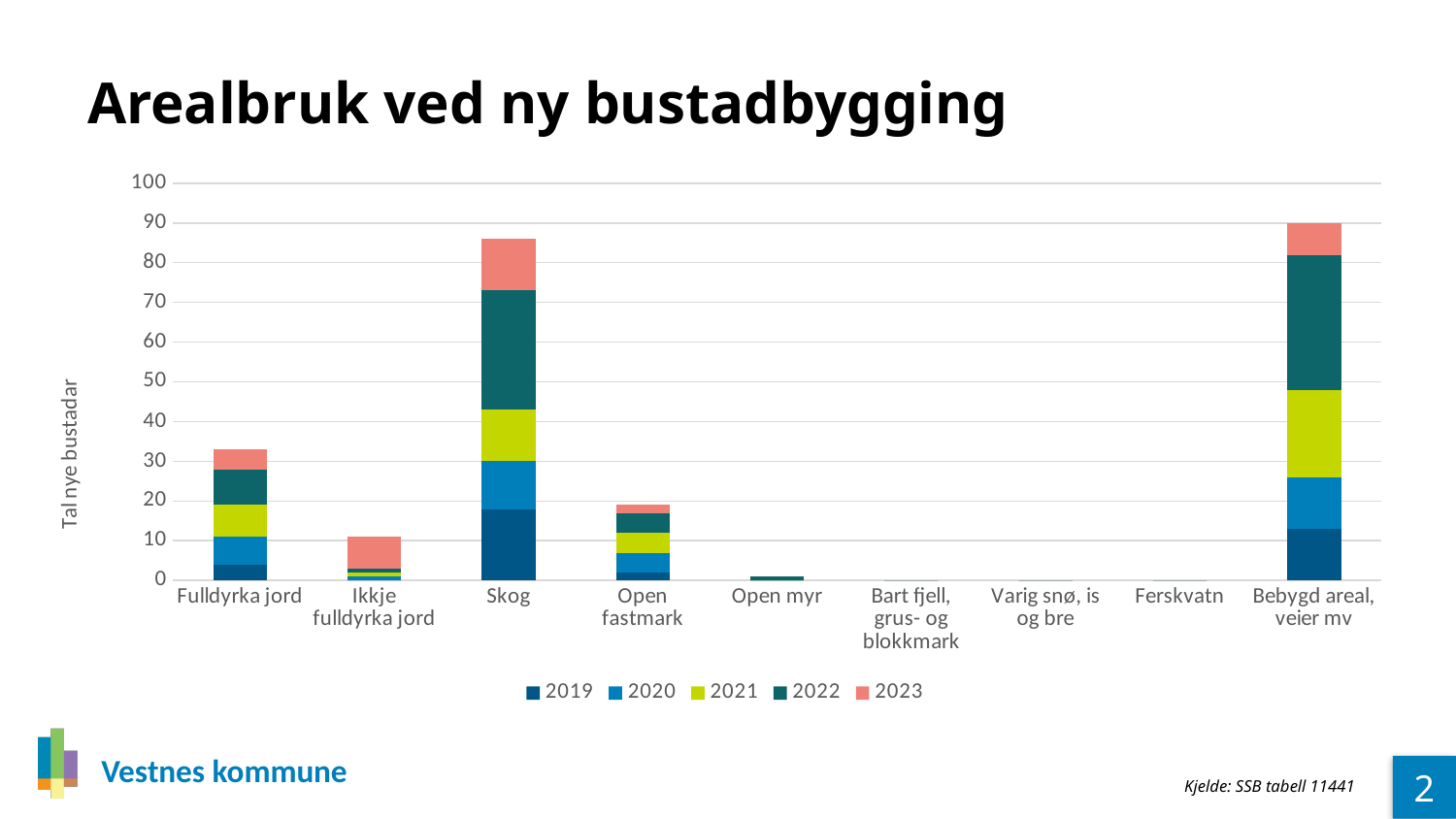
Which has the larger total stacked value, Skog or Fulldyrka jord? Skog Which has the larger total stacked value, Open fastmark or Ikkje fulldyrka jord? Open fastmark How many categories are shown on the x axis of the chart? 9 Is the total stacked value for Open fastmark greater or less than 10? greater What is the title of the chart on the slide? Arealbruk ved ny bustadbygging How many series does the chart's legend list? 5 Is the total stacked value for Skog greater or less than 80? greater Is the total stacked value for Ikkje fulldyrka jord greater or less than 20? less What is the label on the vertical axis of the chart? Tal nye bustadar What kind of chart is shown on the slide? Stacked bar chart